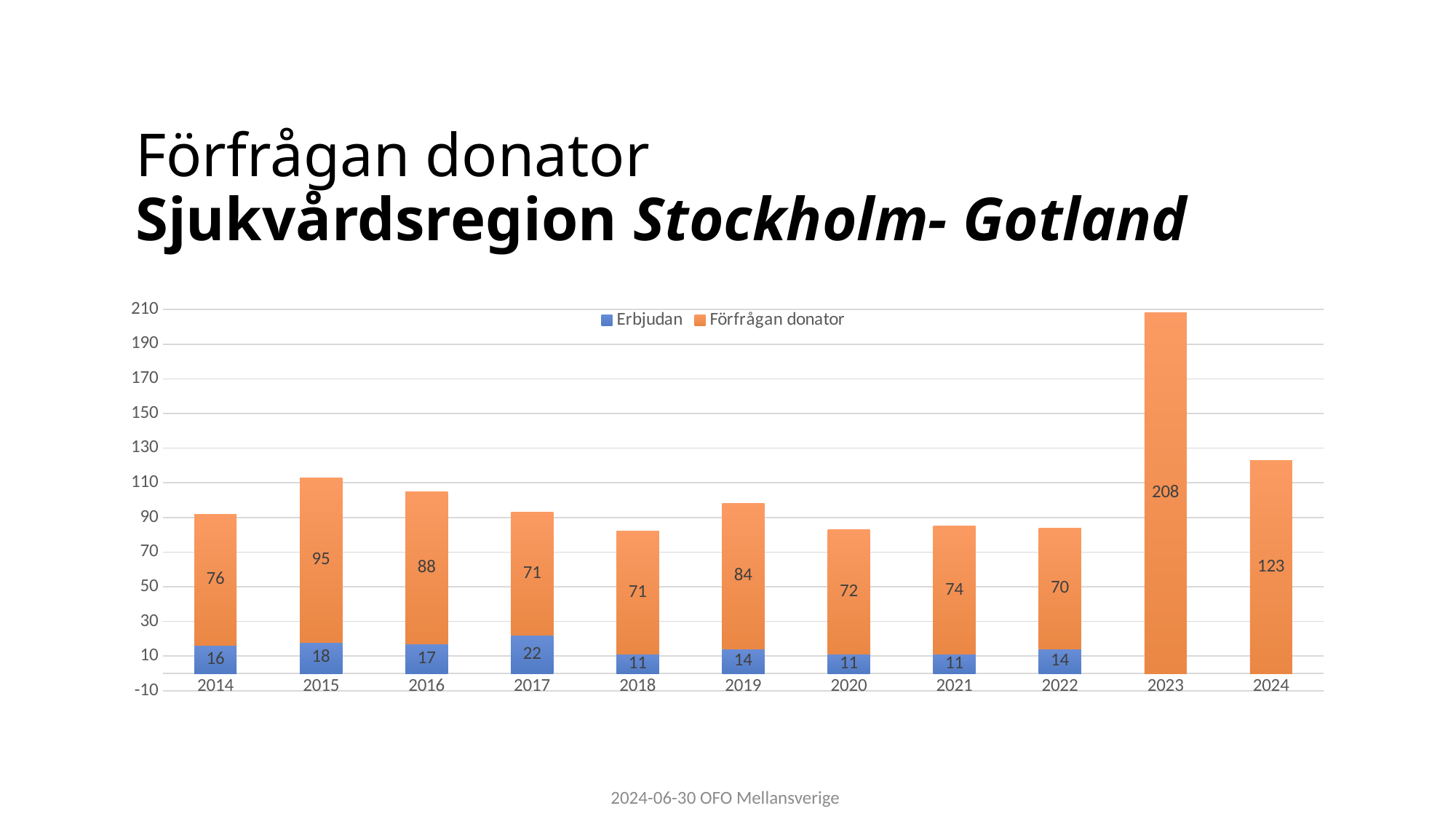
What is the Förfrågan donator value for 2015? 95 What kind of chart is shown on the slide? Stacked bar chart How many series does the legend list? 2 Which year has the lowest Förfrågan donator value? 2022 What is the Erbjudan value for 2017? 22 What is the Förfrågan donator value for 2023? 208 Is the total height of the 2015 stacked bar greater or less than 110? greater Which year has the highest Förfrågan donator value? 2023 How many years are shown on the x axis? 11 What is the total of the stacked bar for 2014? 92 What is the difference between the Förfrågan donator values for 2023 and 2024? 85 Which is larger, the Erbjudan value for 2015 or for 2016? 2015